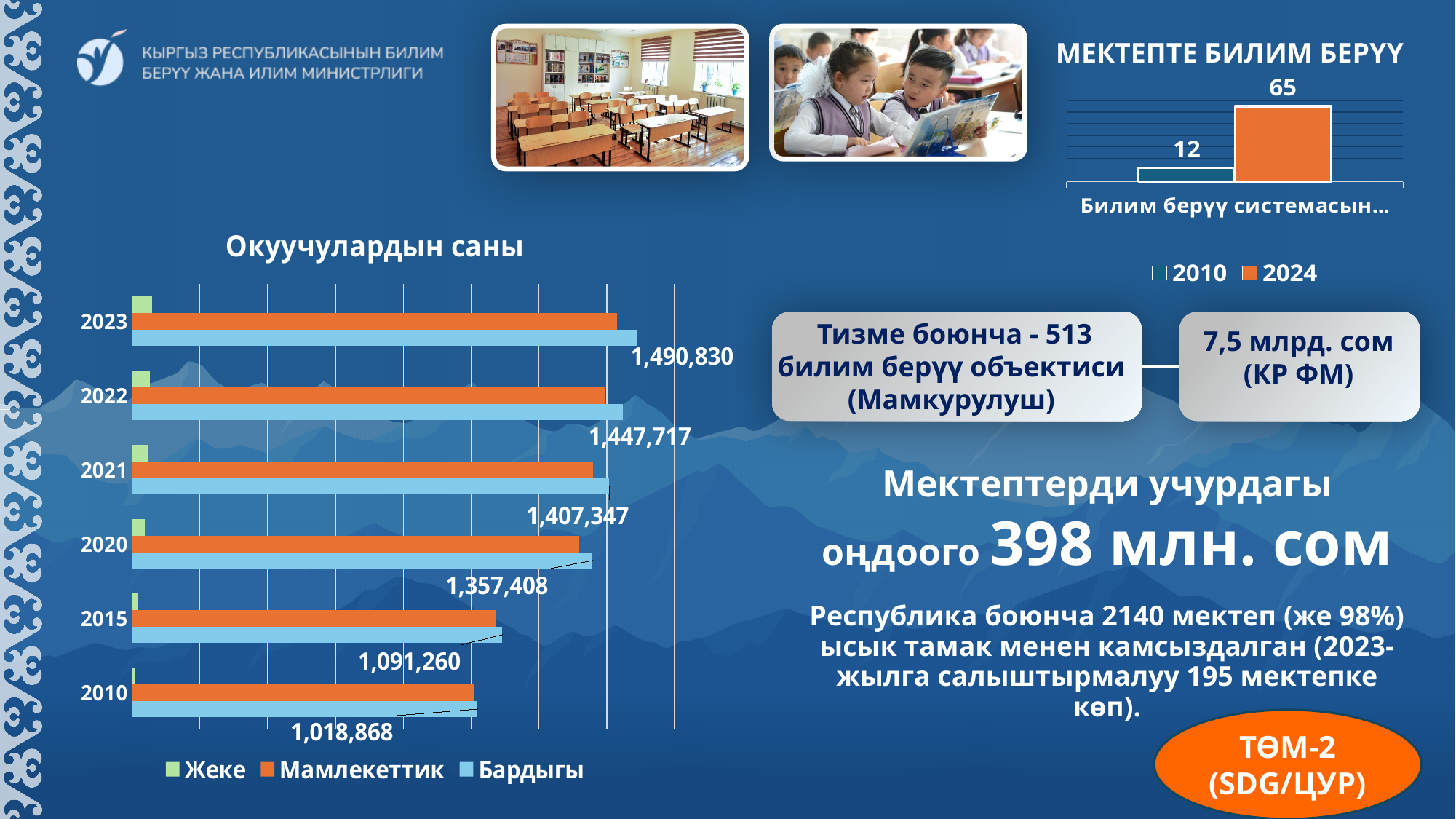
In the chart titled "Окуучулардын саны", how many years are shown on the vertical axis? 6 In the chart titled "Окуучулардын саны", does the Бардыгы value rise or fall from 2010 to 2023? rise In the chart titled "Окуучулардын саны", which year has the lowest Бардыгы value? 2010 In the chart titled "Окуучулардын саны", what is the difference between the Бардыгы values for 2023 and 2022? 43,113 In the chart titled "Окуучулардын саны", which year has the highest Бардыгы value? 2023 In the chart titled "Окуучулардын саны", what is the value of the Бардыгы series for 2020? 1,357,408 What kind of chart is the chart titled "Окуучулардын саны"? bar chart In the chart titled "МЕКТЕПТЕ БИЛИМ БЕРҮҮ", what is the value for 2024? 65 In the chart titled "Окуучулардын саны", how many series does the legend list? 3 In the chart titled "МЕКТЕПТЕ БИЛИМ БЕРҮҮ", what is the difference between the 2024 and 2010 values? 53 In the chart titled "Окуучулардын саны", what is the value of the Бардыгы series for 2010? 1,018,868 In the chart titled "Окуучулардын саны", what is the value of the Бардыгы series for 2023? 1,490,830